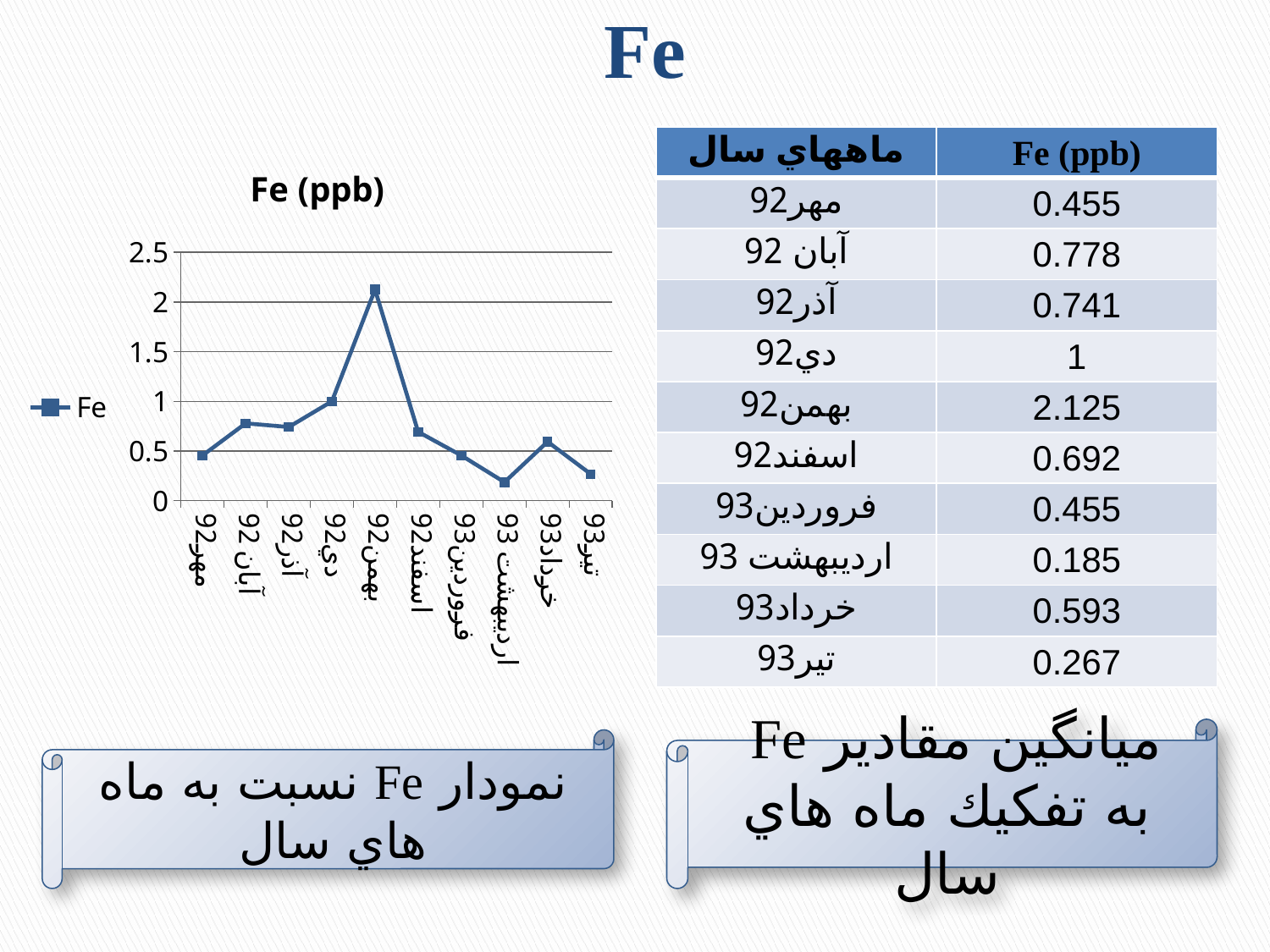
Which month has the highest Fe (ppb) value? بهمن92 Is the Fe (ppb) value for بهمن92 greater or less than 2? greater How many series does the chart legend list? 1 What is the difference between the Fe (ppb) values for بهمن92 and ارديبهشت 93? 1.94 Which has a larger Fe (ppb) value, آبان 92 or تير93? آبان 92 What is the Fe (ppb) value for تير93? 0.267 How many months are plotted on the x axis of the chart? 10 Which month has the lowest Fe (ppb) value? ارديبهشت 93 What type of chart is shown on the slide? line chart What is the title of the chart? Fe (ppb) What is the Fe (ppb) value for دي92? 1 What is the Fe (ppb) value for بهمن92? 2.125